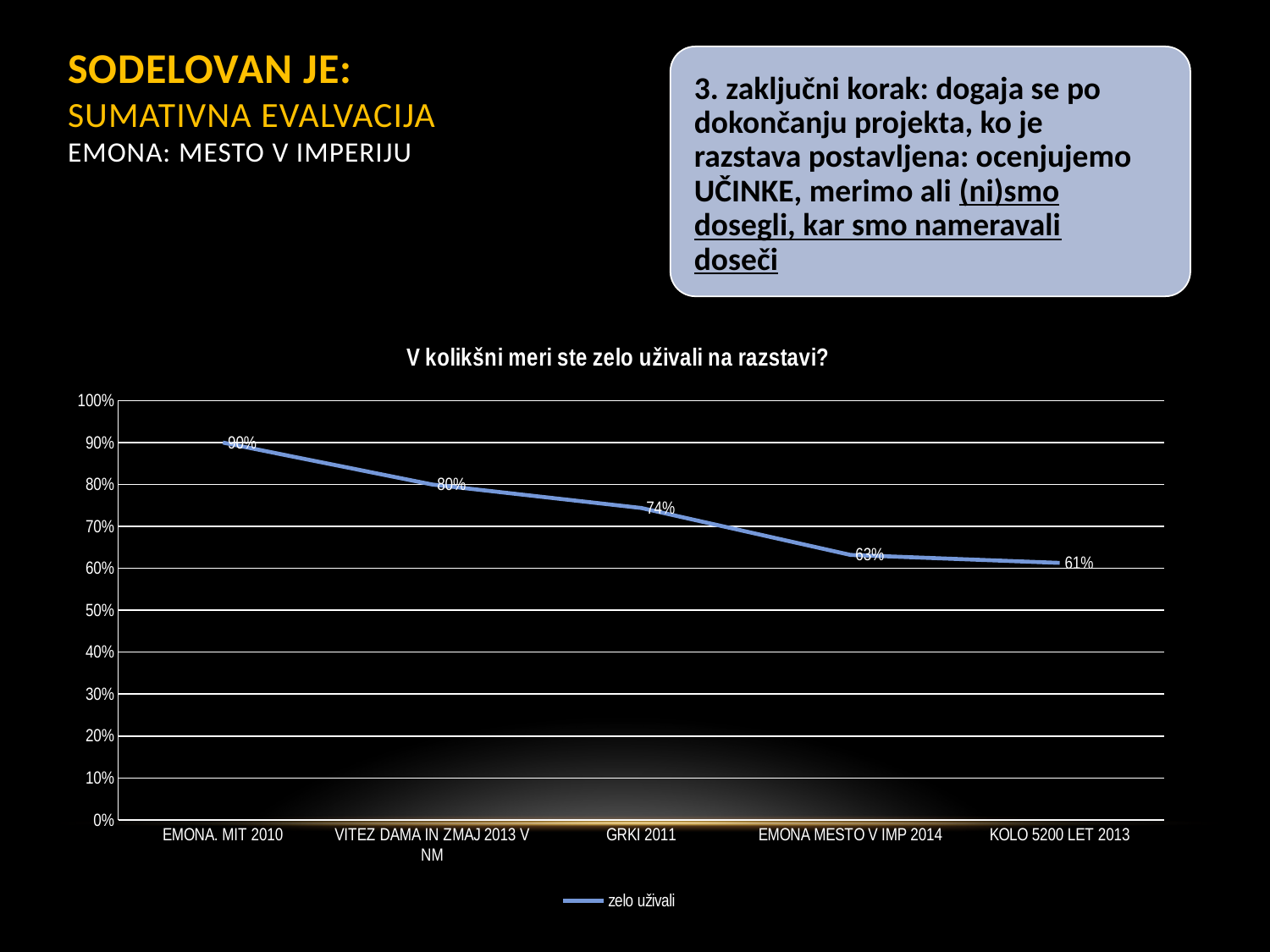
Which category has the highest value? EMONA. MIT 2010 What is the value for GRKI 2011? 74% How many categories are plotted on the x axis? 5 What is the value for EMONA. MIT 2010? 90% How many series does the legend list? 1 What is the value for KOLO 5200 LET 2013? 61% What is the difference between the values for EMONA. MIT 2010 and VITEZ DAMA IN ZMAJ 2013 V NM? 10% Which category has the lowest value? KOLO 5200 LET 2013 Do the values rise or fall from left to right along the x axis? fall Which is larger, the value for GRKI 2011 or the value for EMONA MESTO V IMP 2014? GRKI 2011 What is the value for EMONA MESTO V IMP 2014? 63% What kind of chart is shown? line chart